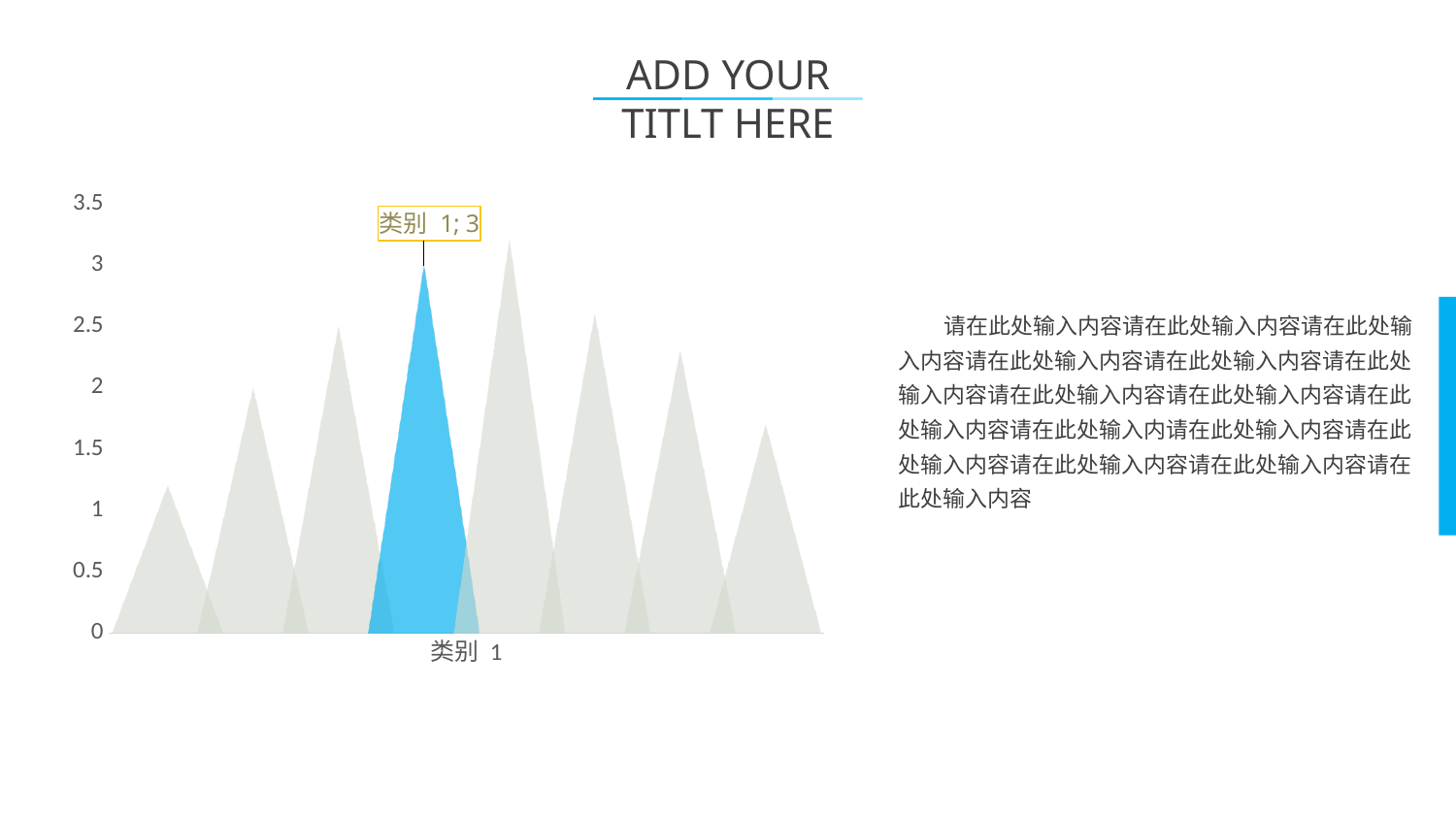
What text does the data label on the blue shape read? 类别 1; 3 How many categories are labelled on the x axis? 1 What is the category label shown on the x axis? 类别 1 What value is shown by the data label on the blue highlighted shape? 3 Is the value of the blue highlighted shape for 类别 1 greater or less than 2.5? greater What is the highest value shown on the y axis? 3.5